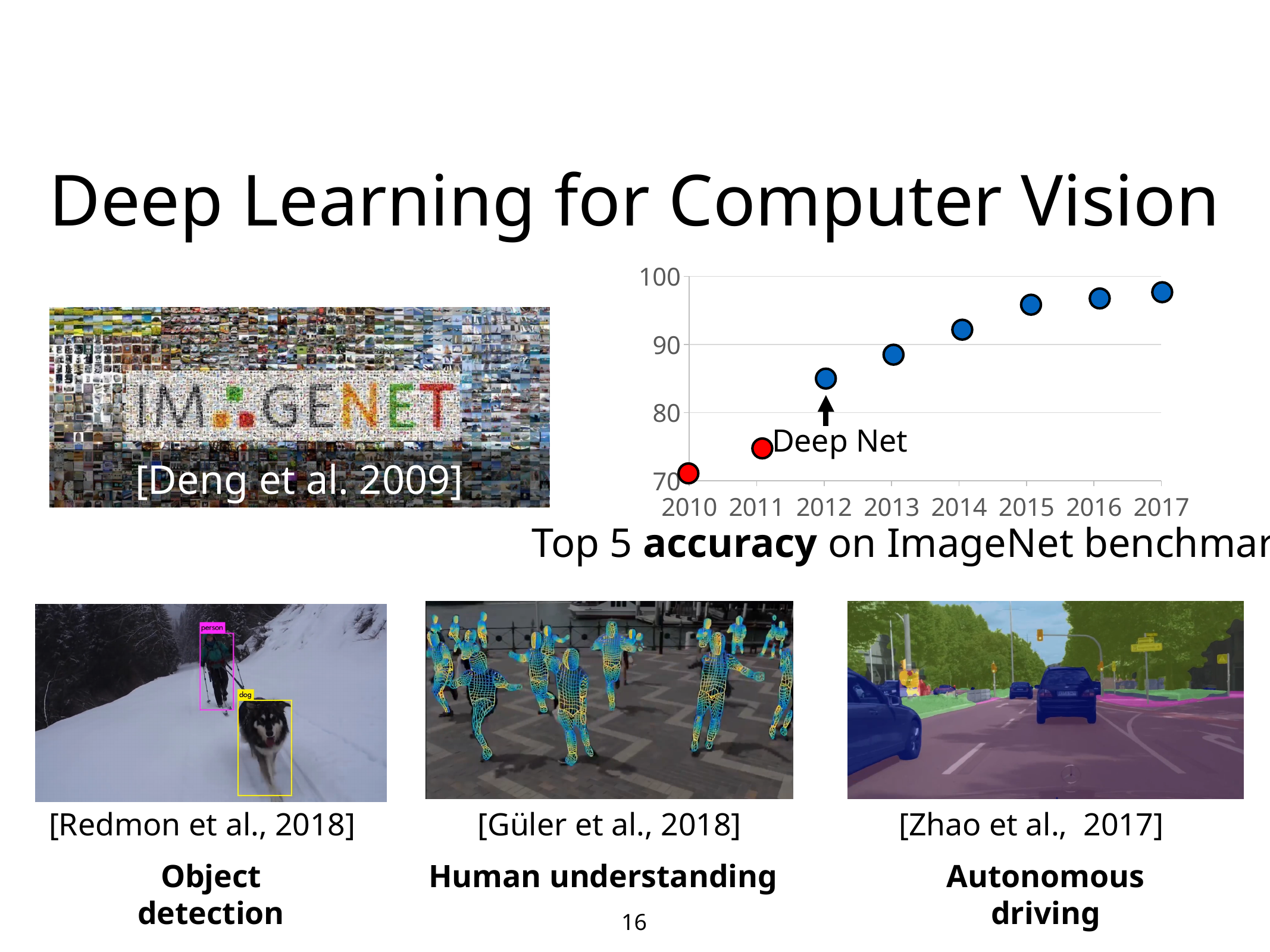
Which is larger, the value for 2011 or the value for 2012? 2012 What kind of chart is shown on the slide? scatter plot Which is larger, the value for 2014 or the value for 2013? 2014 Is the value for 2012 greater or less than 80? greater How many data points are plotted in the chart? 8 Is the value for 2011 greater or less than 80? less Do the values in the chart rise or fall from 2010 to 2017? rise Is the value for 2013 greater or less than 90? less What does the caption below the chart say it shows? Top 5 accuracy on ImageNet benchmark Which year has the lowest value in the chart? 2010 Which year's point is annotated with the label "Deep Net"? 2012